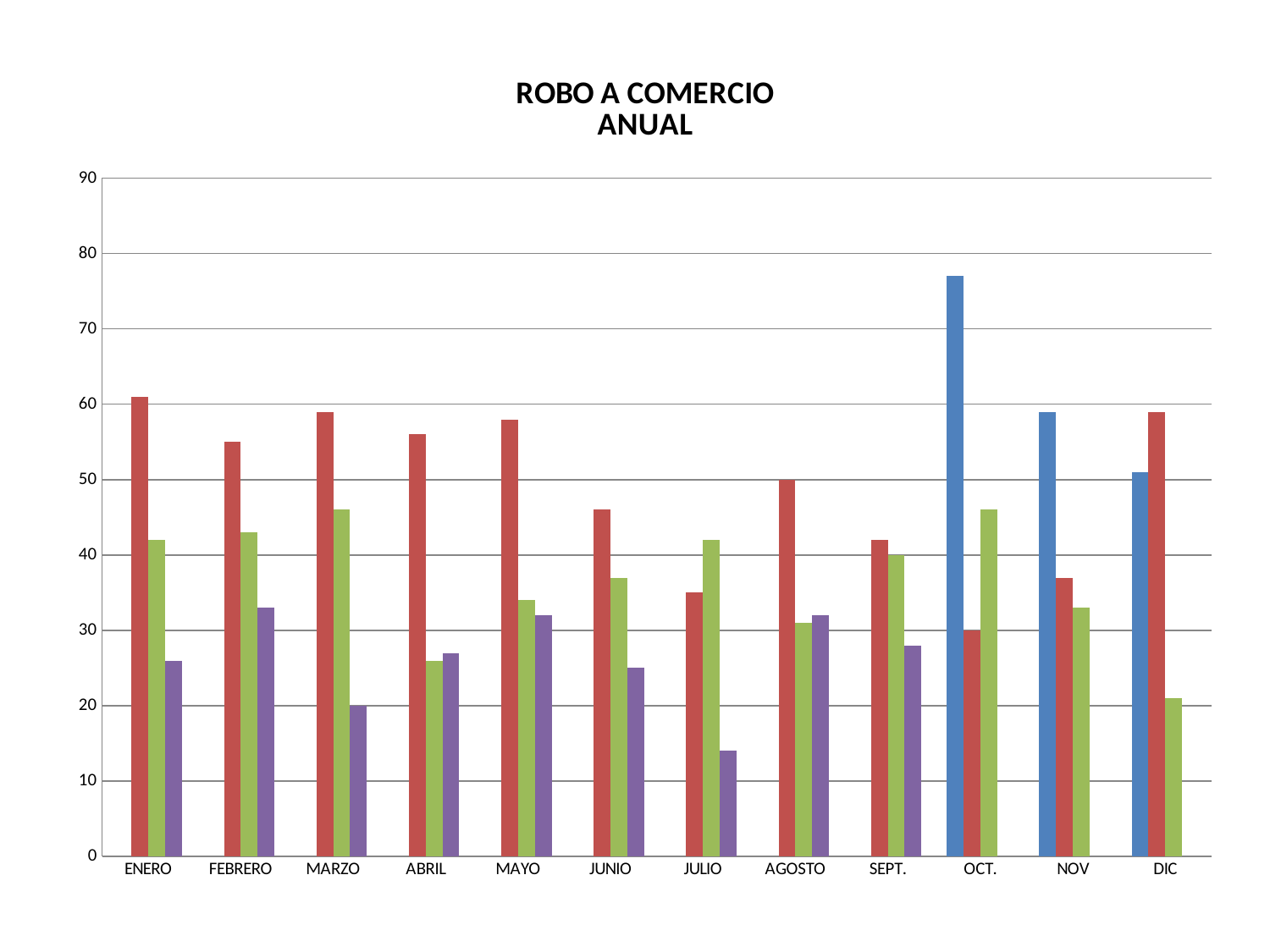
Is the value of the purple bar for JULIO greater or less than 20? less Is the value of the red bar for ENERO greater or less than 60? greater Which month has the lowest purple bar? JULIO Which is larger in DIC, the blue bar or the red bar? the red bar Is the value of the red bar for NOV greater or less than 40? less What is the title of the chart? ROBO A COMERCIO ANUAL In which month does the tallest bar on the chart appear? OCT. How many months (categories) are shown on the x axis? 12 What kind of chart is shown on the slide? bar chart Which is larger in JULIO, the red bar or the green bar? the green bar